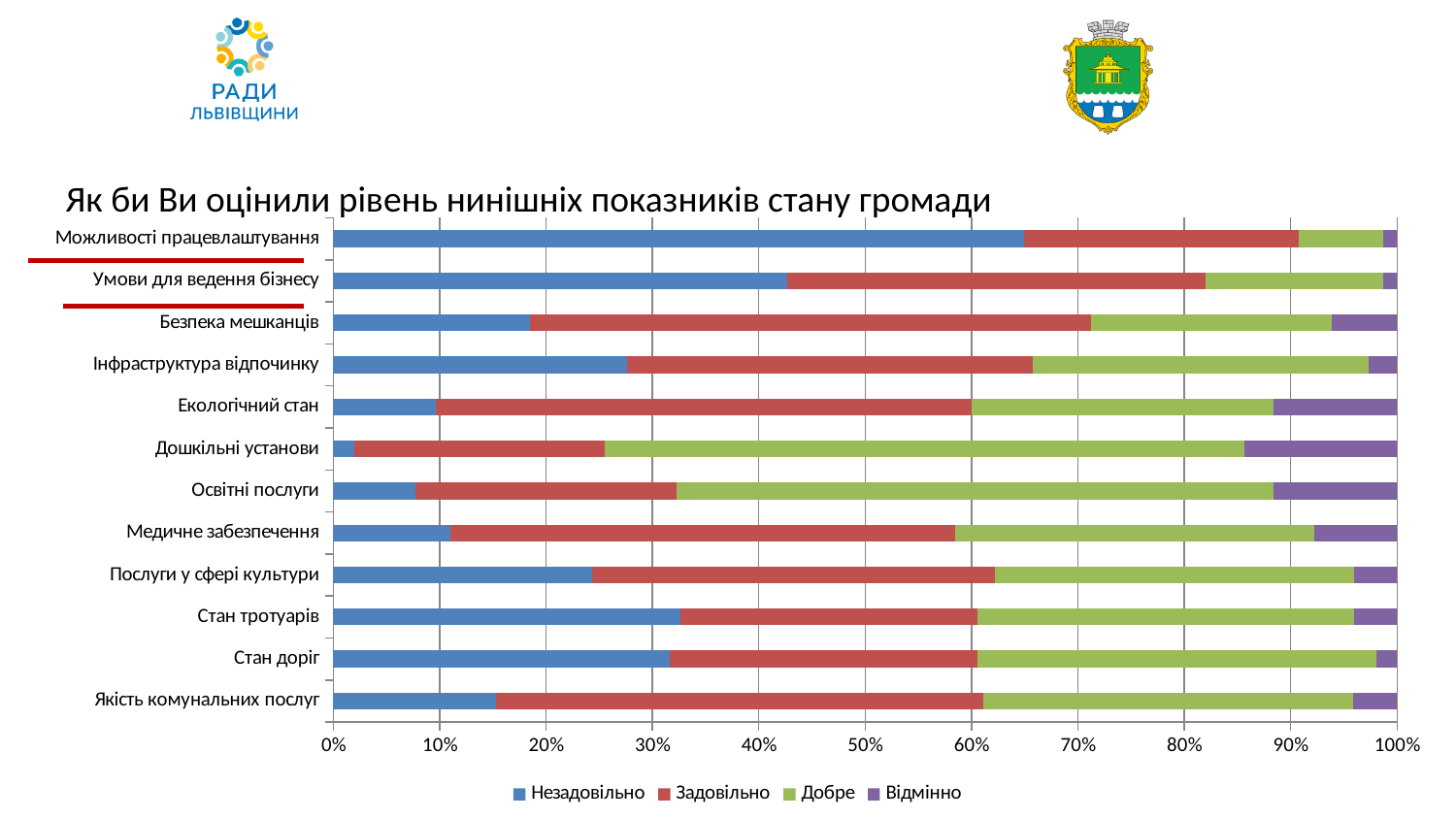
Is the "Незадовільно" value for "Умови для ведення бізнесу" greater or less than 40%? greater Is the "Незадовільно" value for "Можливості працевлаштування" greater or less than 60%? greater Which has a larger "Незадовільно" share: "Стан тротуарів" or "Освітні послуги"? Стан тротуарів What kind of chart is shown on the slide? Stacked bar chart Which category has the smallest "Незадовільно" segment? Дошкільні установи How many categories are plotted on the chart? 12 How many series does the legend list? 4 What is the title of the chart? Як би Ви оцінили рівень нинішніх показників стану громади Which colour represents the series "Добре" in the legend? Green Is the "Незадовільно" value for "Якість комунальних послуг" greater or less than 20%? less Which category has the largest "Незадовільно" segment? Можливості працевлаштування